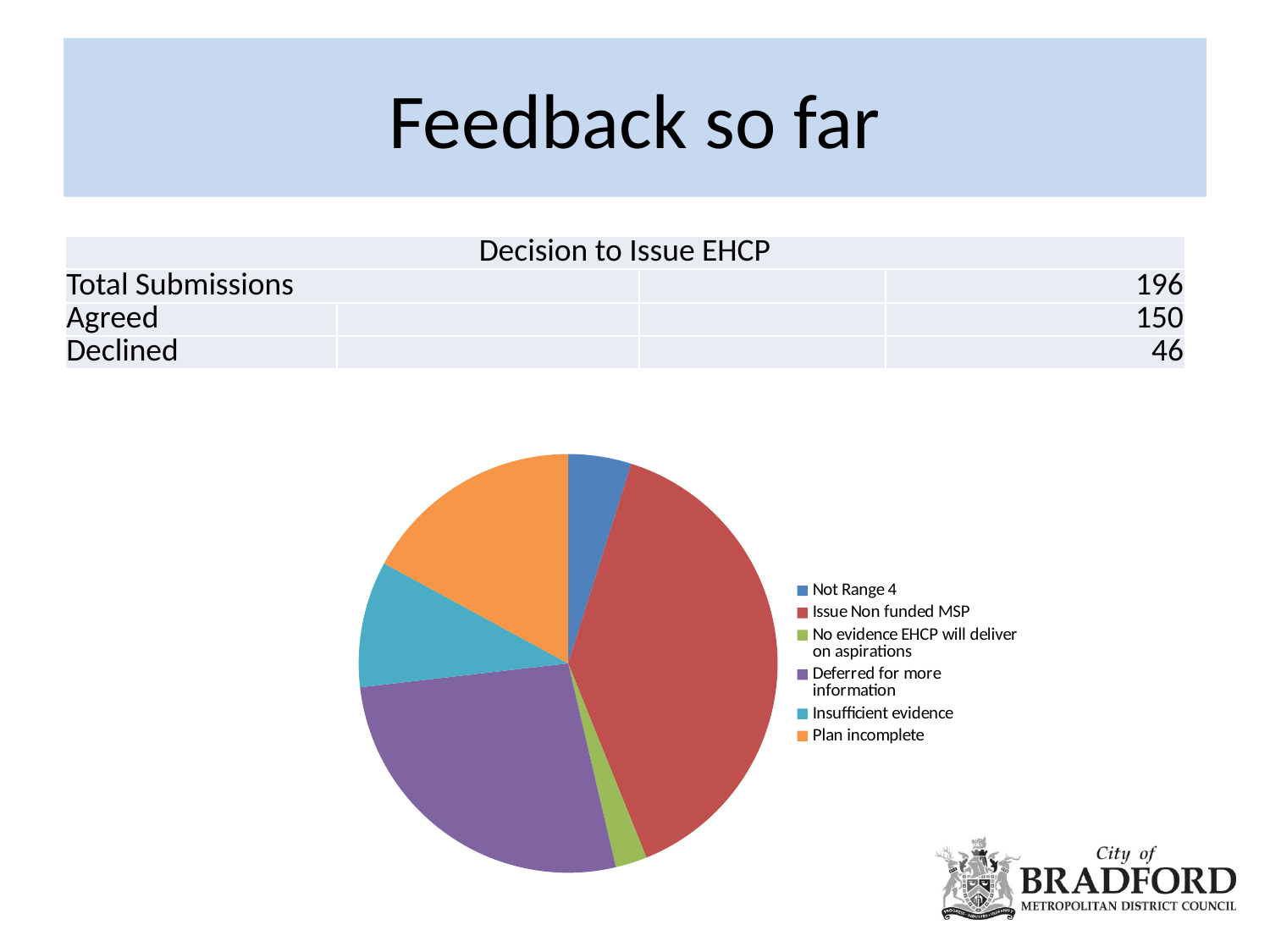
How many slices does the pie chart have? 6 Which category has the smallest slice of the pie chart? No evidence EHCP will deliver on aspirations Which category has the largest slice of the pie chart? Issue Non funded MSP Which category is shown in purple in the pie chart? Deferred for more information Which slice is larger: Issue Non funded MSP or Deferred for more information? Issue Non funded MSP Which slice is larger: Not Range 4 or No evidence EHCP will deliver on aspirations? Not Range 4 What colour is the Plan incomplete slice in the pie chart? orange Which slice is larger: Plan incomplete or Insufficient evidence? Plan incomplete What kind of chart is shown on the slide? pie chart How many entries does the pie chart's legend list? 6